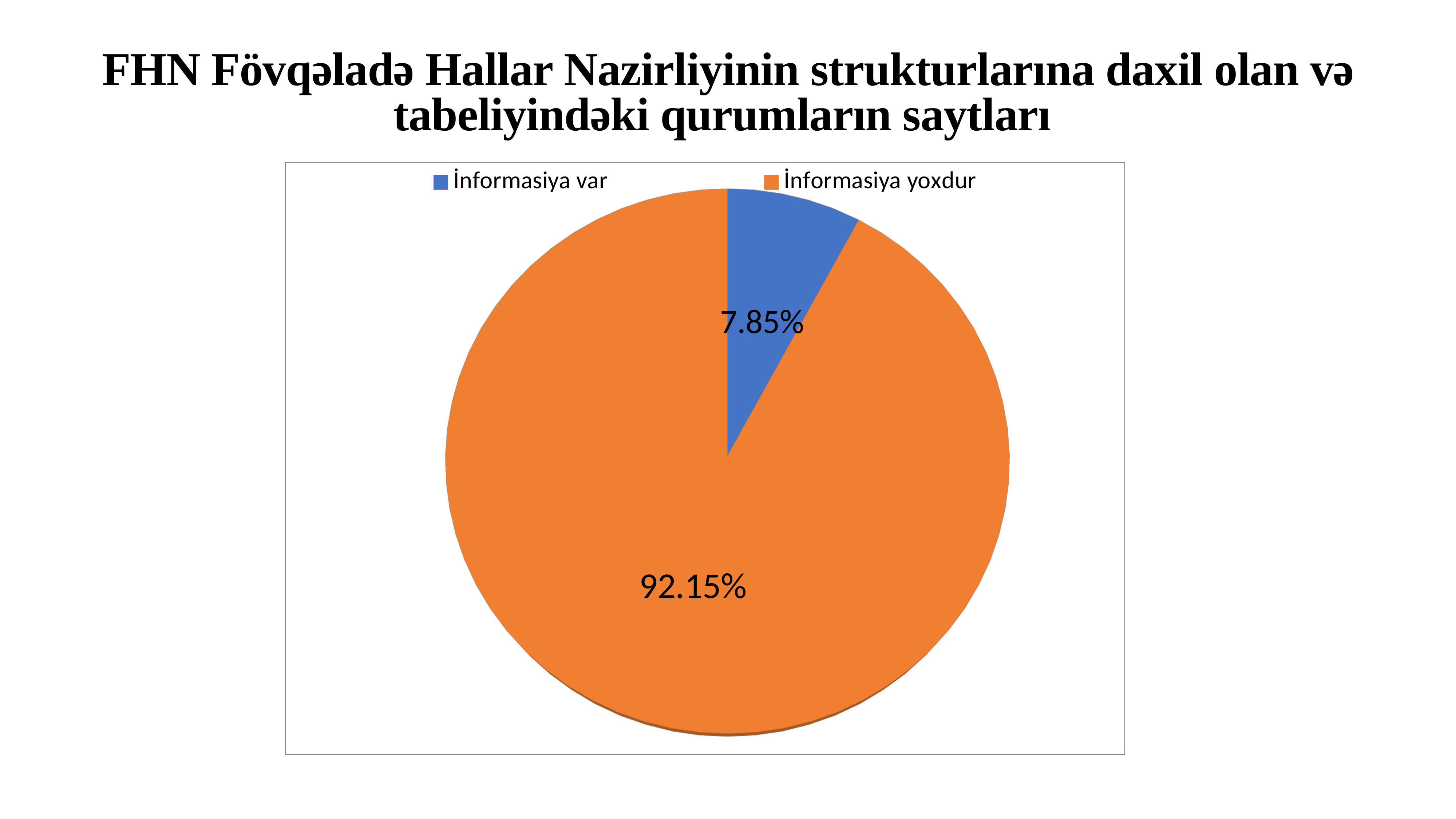
What kind of chart is shown on the slide? pie chart What is the difference between the İnformasiya yoxdur and İnformasiya var values? 84.30% How many entries does the legend list? 2 What is the value for İnformasiya var? 7.85% Which is larger, İnformasiya var or İnformasiya yoxdur? İnformasiya yoxdur Which category has the smallest slice? İnformasiya var How many slices does the pie chart have? 2 What colour is the İnformasiya yoxdur slice? orange What share of the pie does İnformasiya var take? 7.85% What is the value for İnformasiya yoxdur? 92.15% What colour is the İnformasiya var slice? blue Which category has the largest slice? İnformasiya yoxdur